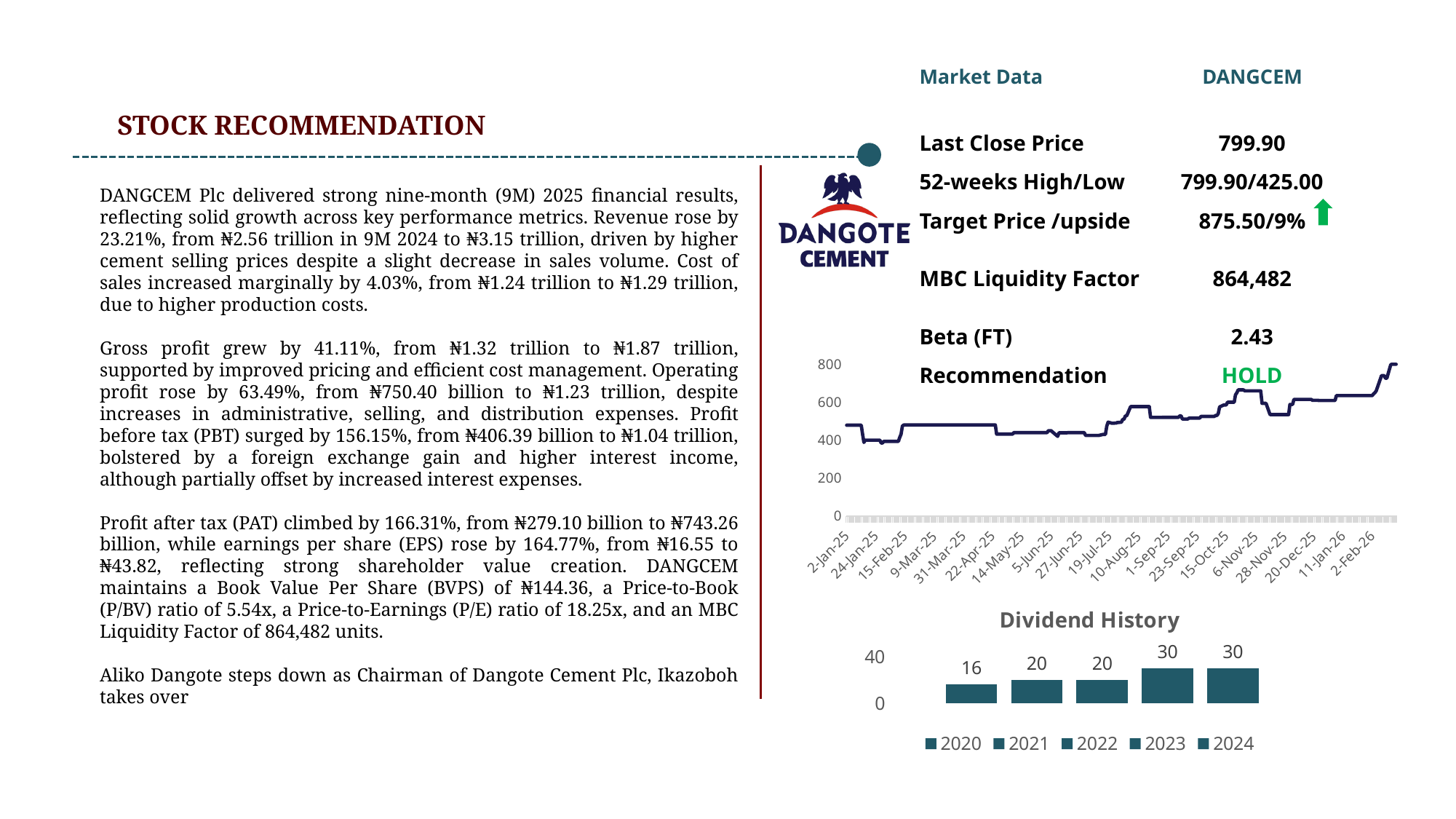
In the Dividend History chart, what is the value for 2024? 30 How many entries does the legend of the Dividend History chart list? 5 In the Dividend History chart, which year has the lowest value? 2020 What kind of chart is the Dividend History chart? bar chart In the Dividend History chart, what is the value for 2022? 20 What kind of chart is the price chart above the Dividend History chart? line chart How many bars are shown in the Dividend History chart? 5 In the price line chart, does the value overall rise or fall from 2-Jan-25 to 2-Feb-26? rise In the Dividend History chart, what is the value for 2020? 16 In the Dividend History chart, which is larger, the value for 2021 or the value for 2023? 2023 In the Dividend History chart, what is the difference between the values for 2024 and 2020? 14 In the price line chart, is the value at 2-Feb-26 greater or less than 600? greater